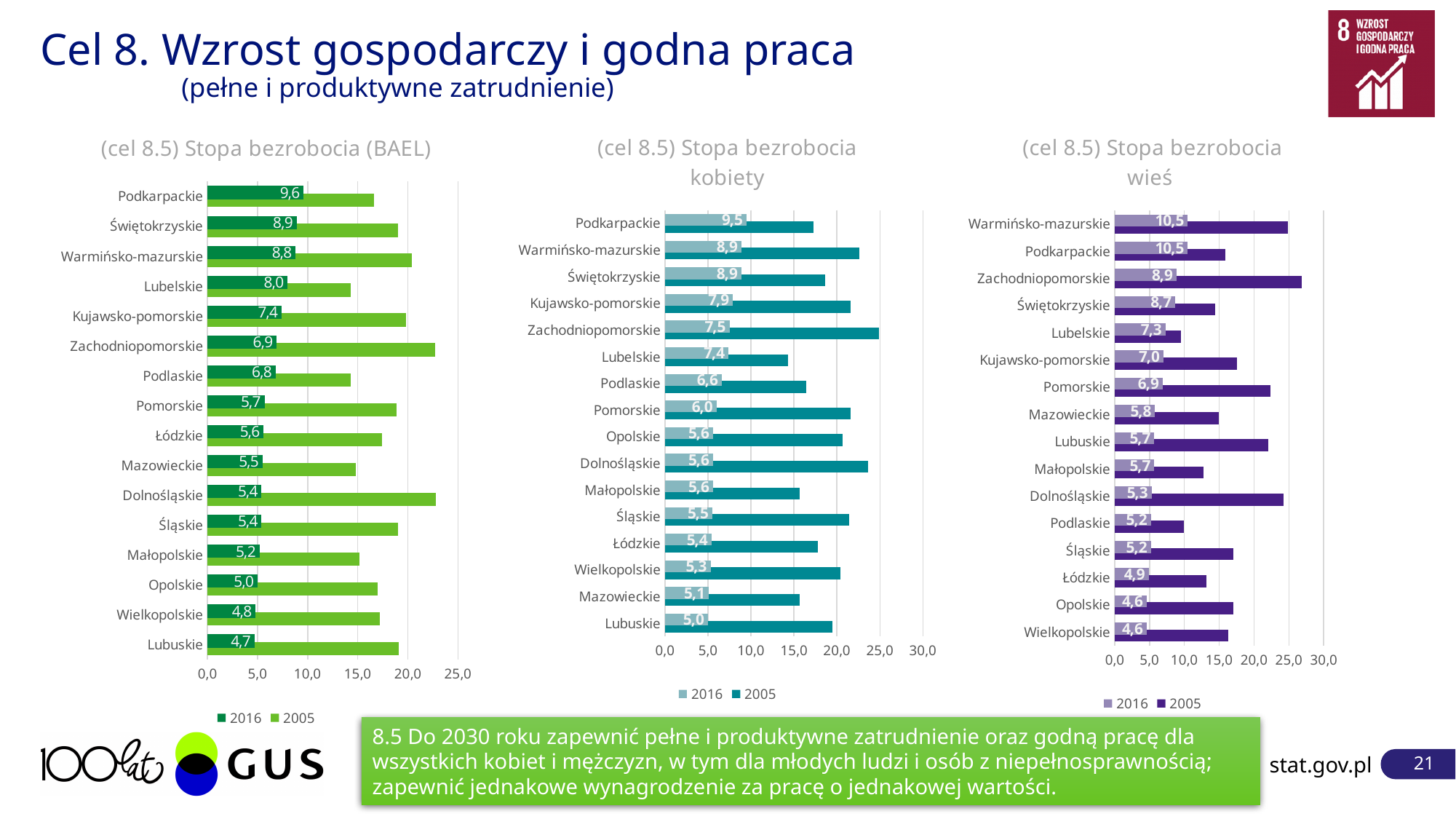
In the chart titled "(cel 8.5) Stopa bezrobocia (BAEL)", which region has the lowest 2016 value? Lubuskie What type of chart is the chart titled "(cel 8.5) Stopa bezrobocia (BAEL)"? Bar chart In the chart titled "(cel 8.5) Stopa bezrobocia kobiety", how many regions are listed? 16 In the chart titled "(cel 8.5) Stopa bezrobocia kobiety", what is the difference between the 2016 values for Podkarpackie and Lubuskie? 4,5 In the chart titled "(cel 8.5) Stopa bezrobocia wieś", which 2016 value is larger: Lubelskie or Mazowieckie? Lubelskie In the chart titled "(cel 8.5) Stopa bezrobocia kobiety", what is the 2016 value for Pomorskie? 6,0 In the chart titled "(cel 8.5) Stopa bezrobocia wieś", how many series does the legend list? 2 In the chart titled "(cel 8.5) Stopa bezrobocia wieś", what is the 2016 value for Kujawsko-pomorskie? 7,0 In the chart titled "(cel 8.5) Stopa bezrobocia (BAEL)", what is the 2016 value for Lubelskie? 8,0 In the chart titled "(cel 8.5) Stopa bezrobocia (BAEL)", which region has the highest 2016 value? Podkarpackie In the chart titled "(cel 8.5) Stopa bezrobocia (BAEL)", is the 2005 value for Zachodniopomorskie greater or less than 20,0? greater In the chart titled "(cel 8.5) Stopa bezrobocia wieś", is the 2005 value for Zachodniopomorskie greater or less than 25,0? greater